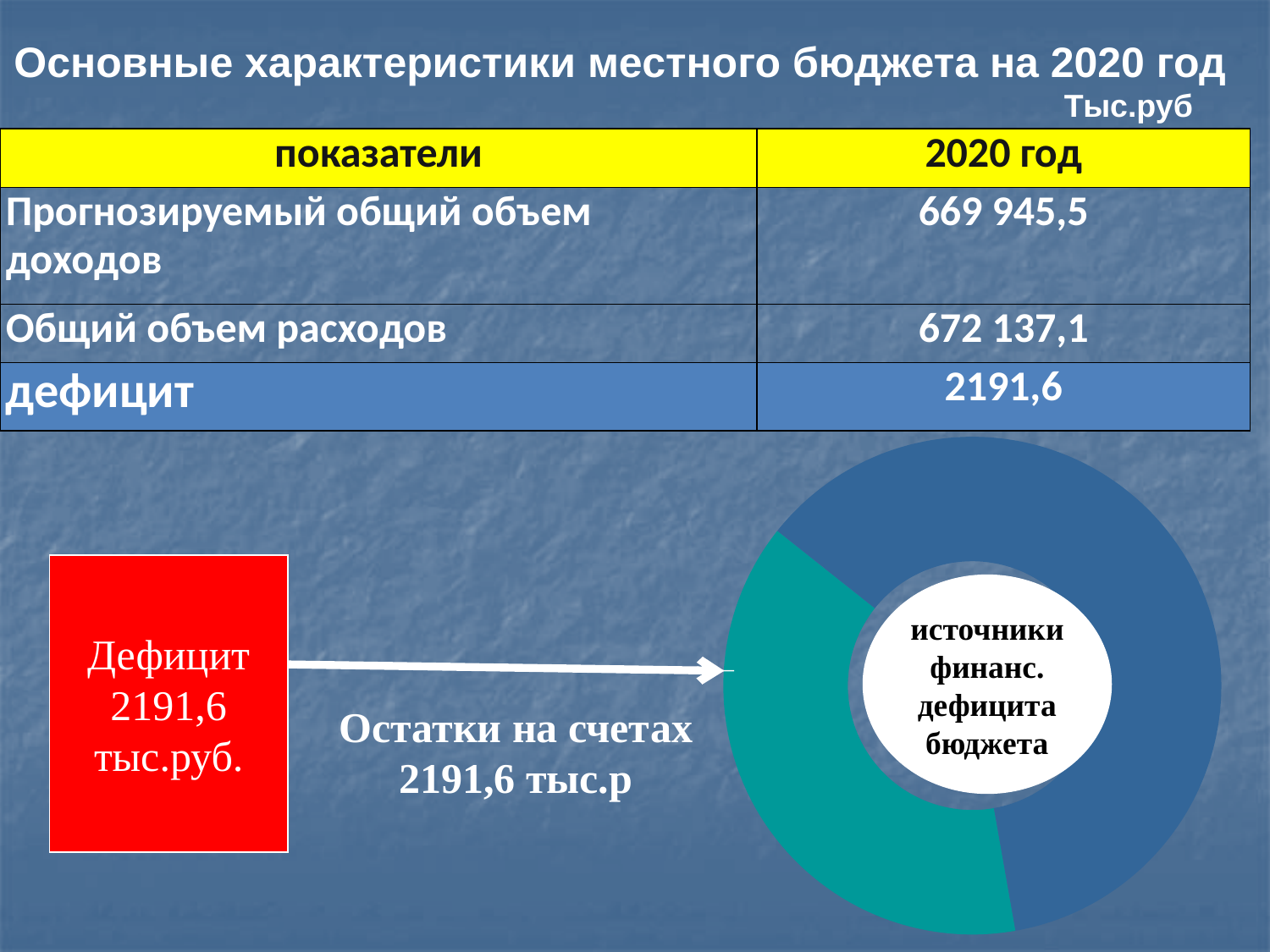
How many slices does the doughnut chart have? 2 Does the doughnut chart display a legend? No Which slice of the doughnut chart is larger, the blue one or the teal one? the blue one Which slice of the doughnut chart is the smallest? the teal slice What text is written in the centre of the doughnut chart? источники финанс. дефицита бюджета What kind of chart is shown in the lower right of the slide? doughnut chart